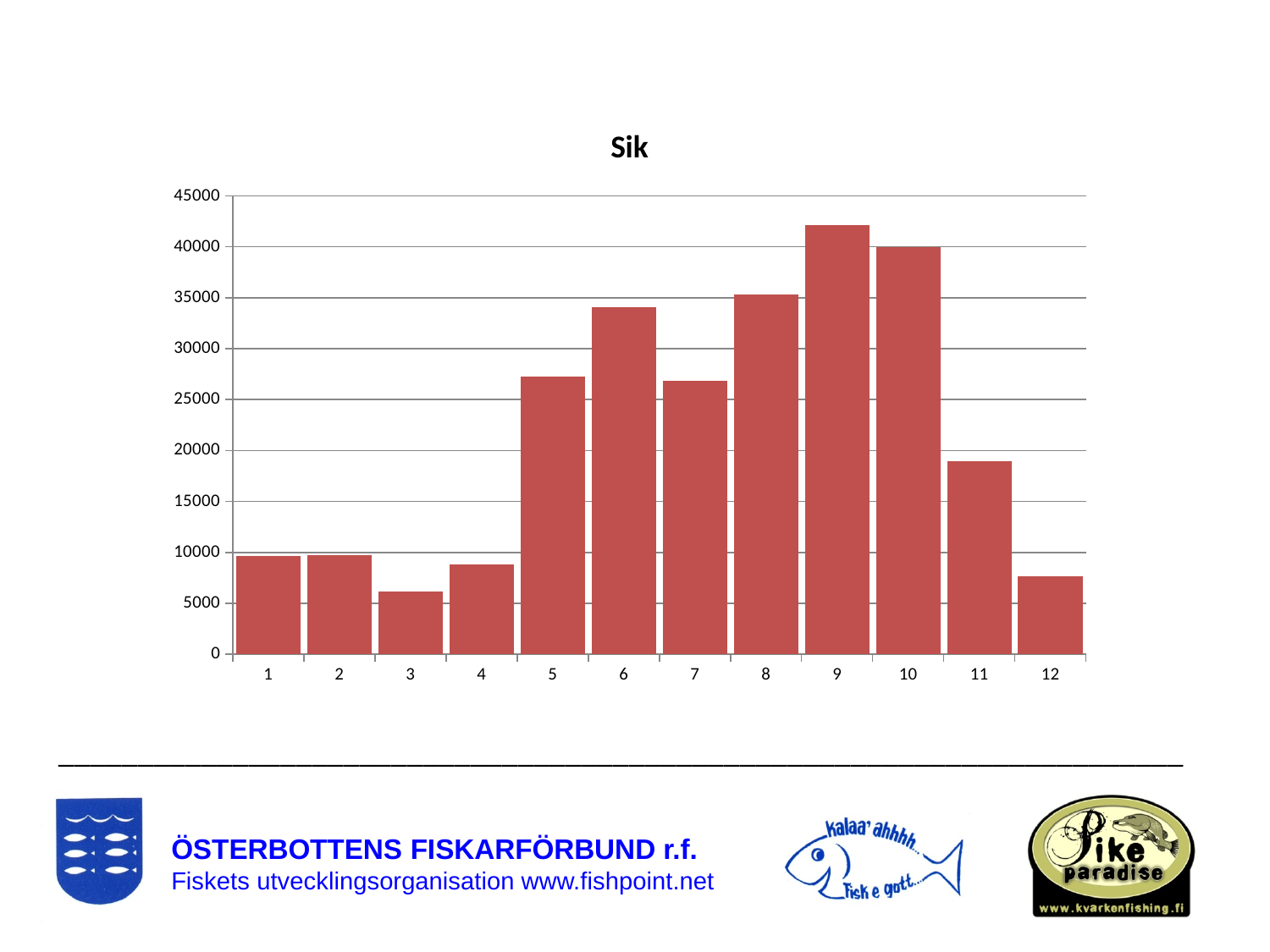
Is the value for category 9 greater or less than 40000? greater Is the value for category 3 greater or less than 10000? less Which category has the highest value in the chart? 9 What kind of chart is shown on the slide? bar chart What is the title of the chart? Sik Is the value for category 11 greater or less than 15000? greater Do the values rise or fall from category 9 to category 12? fall Which has the larger value, category 11 or category 12? 11 How many categories are shown on the x axis of the chart? 12 Which category has the lowest value in the chart? 3 Which has the larger value, category 6 or category 7? 6